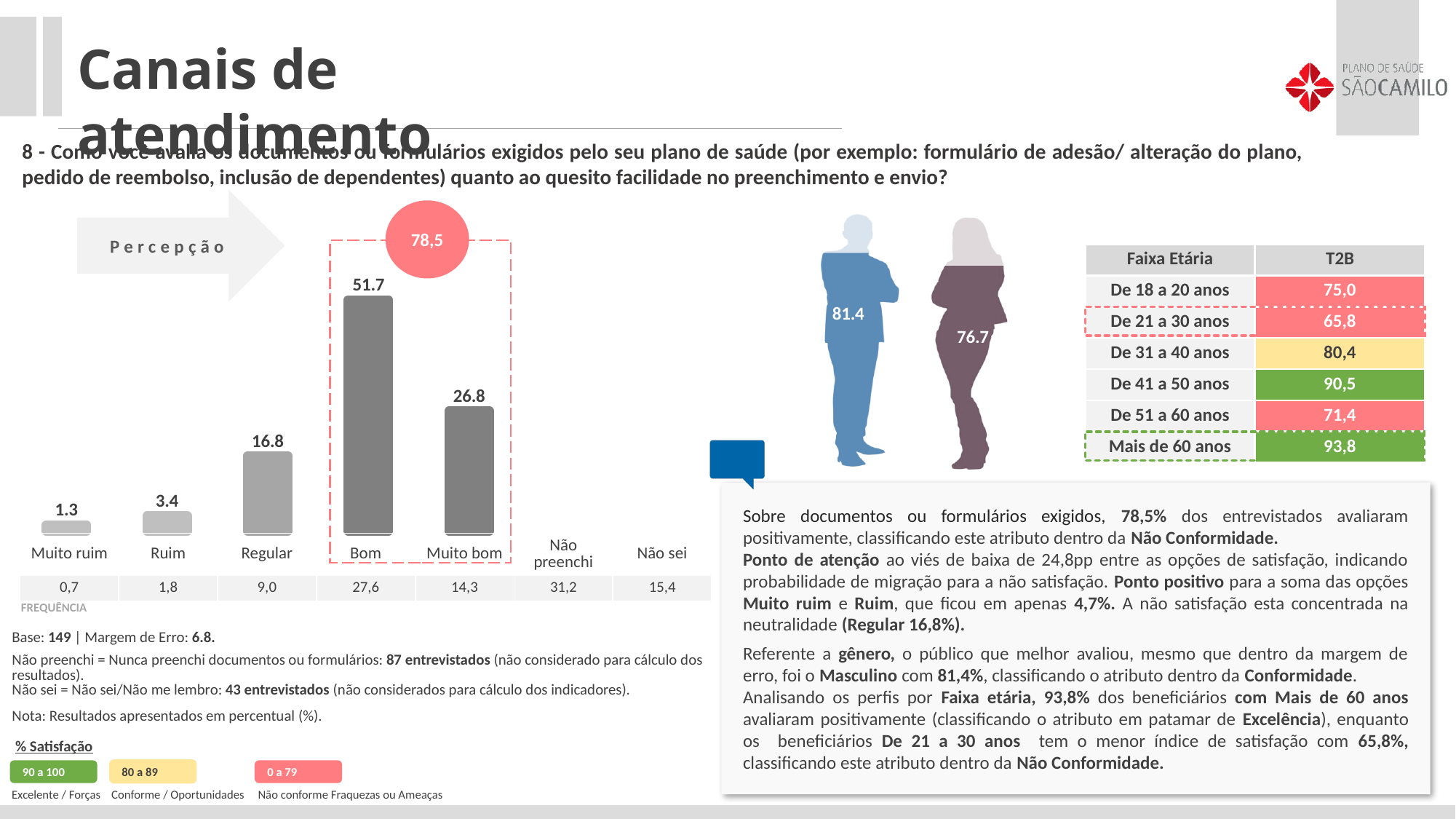
In the bar chart, what is the difference between the values for 'Bom' and 'Muito bom'? 24.9 In the bar chart, which category has the highest value? Bom In the bar chart, what is the value for 'Ruim'? 3.4 In the bar chart, which is larger: the value for 'Regular' or the value for 'Muito bom'? Muito bom In the bar chart, what is the value for 'Muito bom'? 26.8 In the bar chart, what is the value for 'Bom'? 51.7 In the bar chart, which category has the lowest labelled value? Muito ruim In the bar chart, what is the value for 'Regular'? 16.8 In the bar chart, what is the combined value of 'Muito ruim' and 'Ruim'? 4.7 How many bars with data labels are plotted in the bar chart? 5 What kind of chart is shown on the left of the slide under 'Percepção'? bar chart What value is shown in the red circle above the dashed box grouping 'Bom' and 'Muito bom'? 78,5